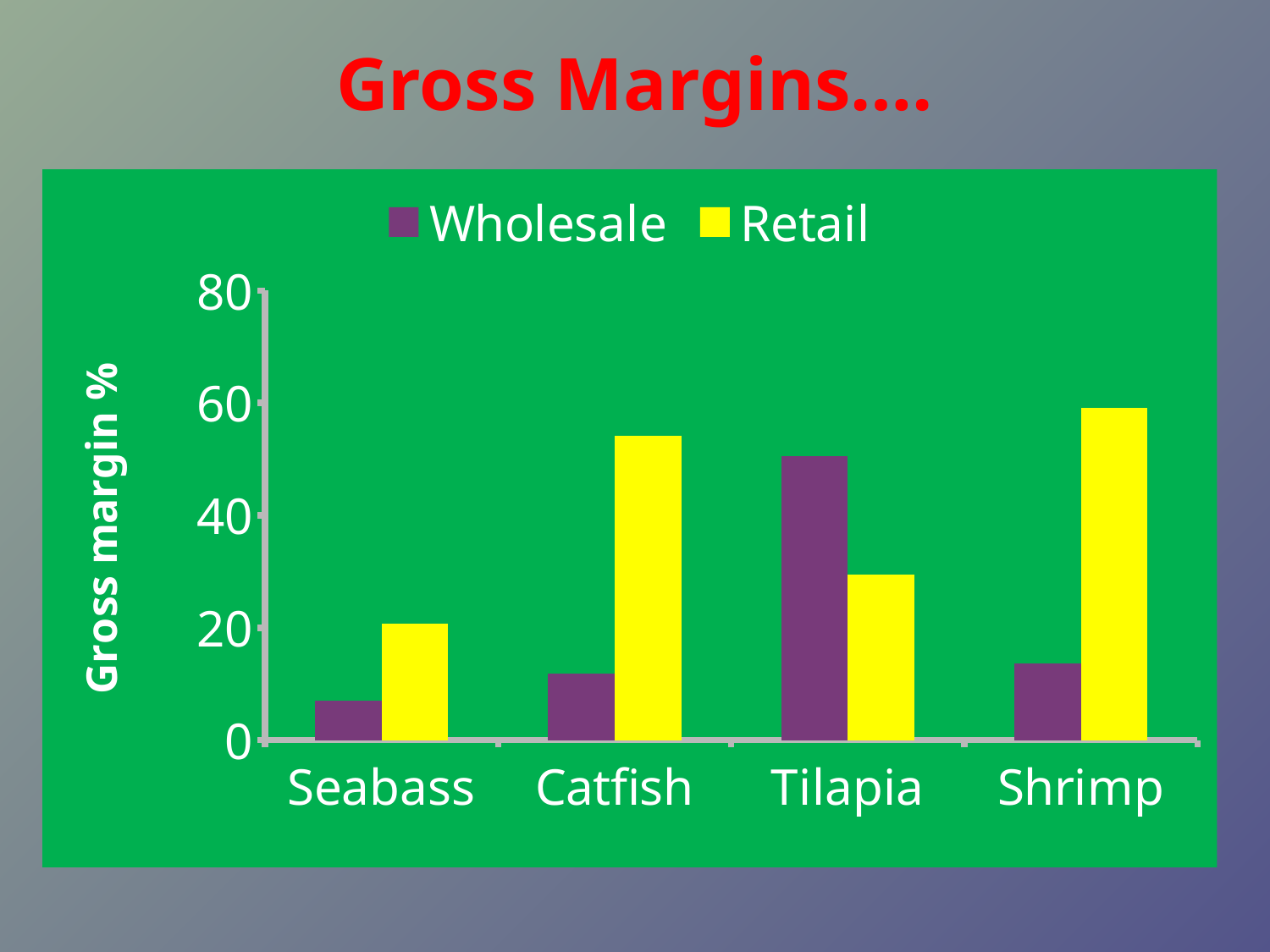
Is the Wholesale value for Tilapia greater or less than 40? greater Is the Retail value for Tilapia greater or less than 40? less Which category has the highest Wholesale gross margin? Tilapia For Tilapia, which is larger, the Wholesale or the Retail gross margin? Wholesale For Catfish, which is larger, the Wholesale or the Retail gross margin? Retail What is the label on the vertical axis? Gross margin % Which category has the lowest Retail gross margin? Seabass What kind of chart is shown on the slide? bar chart How many series does the legend list? 2 How many categories are shown on the x axis? 4 Which category has the lowest Wholesale gross margin? Seabass Which category has the highest Retail gross margin? Shrimp